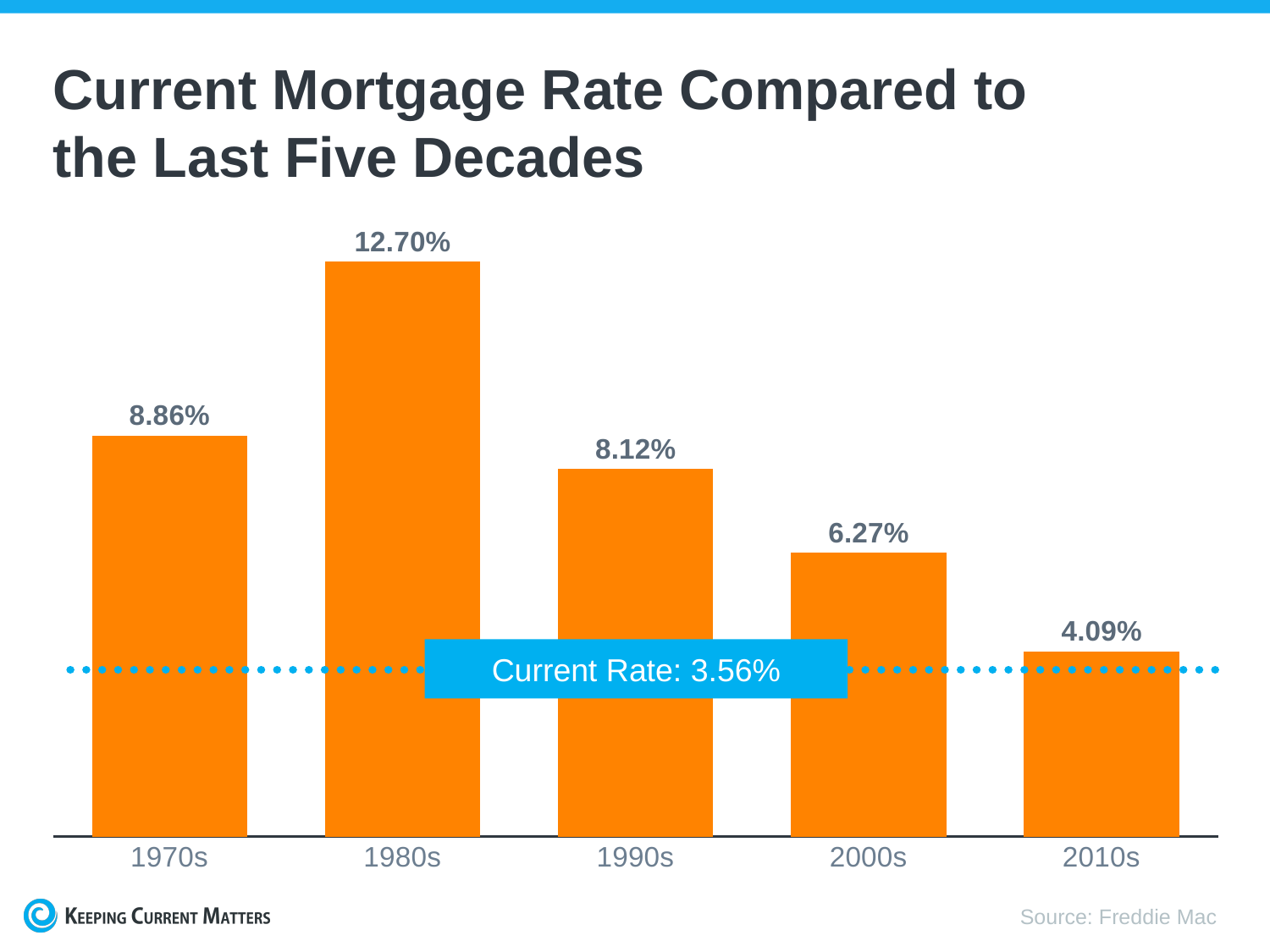
Do the mortgage rates rise or fall from the 1980s to the 2010s? Fall What was the mortgage rate in the 1970s? 8.86% What was the mortgage rate in the 2010s? 4.09% Which decade had the highest mortgage rate? 1980s What kind of chart is shown on the slide? Bar chart What is the difference between the 2010s rate and the current rate shown on the slide? 0.53% What current rate is marked by the dotted line on the chart? 3.56% Which decade had the lowest mortgage rate? 2010s What was the mortgage rate in the 1980s? 12.70% How many decades are shown on the chart? 5 Which decade had a higher mortgage rate, the 1970s or the 2000s? 1970s What is the difference between the 1980s rate and the 1990s rate? 4.58%